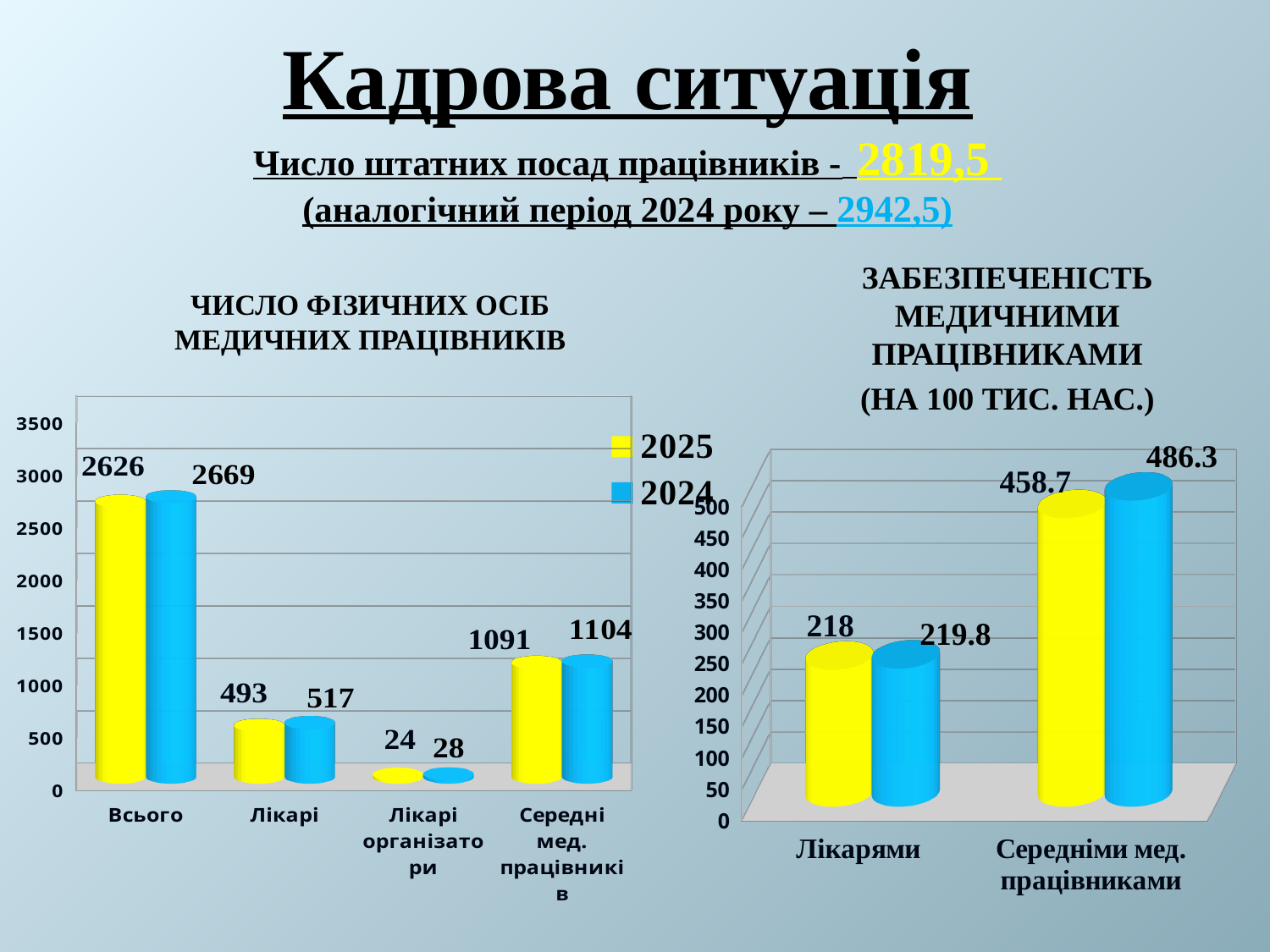
In the right chart (ЗАБЕЗПЕЧЕНІСТЬ МЕДИЧНИМИ ПРАЦІВНИКАМИ), what is the difference between the blue (2024) and yellow (2025) bars for Середніми мед. працівниками? 27.6 In the right chart (ЗАБЕЗПЕЧЕНІСТЬ МЕДИЧНИМИ ПРАЦІВНИКАМИ), what is the value of the yellow (2025) bar for Лікарями? 218 In the left chart (ЧИСЛО ФІЗИЧНИХ ОСІБ МЕДИЧНИХ ПРАЦІВНИКІВ), what is the 2025 value for Всього? 2626 In the left chart (ЧИСЛО ФІЗИЧНИХ ОСІБ МЕДИЧНИХ ПРАЦІВНИКІВ), how many categories are shown on the x axis? 4 In the right chart (ЗАБЕЗПЕЧЕНІСТЬ МЕДИЧНИМИ ПРАЦІВНИКАМИ), what is the value of the blue (2024) bar for Середніми мед. працівниками? 486.3 In the left chart (ЧИСЛО ФІЗИЧНИХ ОСІБ МЕДИЧНИХ ПРАЦІВНИКІВ), which series is shown in yellow? 2025 In the left chart (ЧИСЛО ФІЗИЧНИХ ОСІБ МЕДИЧНИХ ПРАЦІВНИКІВ), what is the 2024 value for Лікарі? 517 In the left chart (ЧИСЛО ФІЗИЧНИХ ОСІБ МЕДИЧНИХ ПРАЦІВНИКІВ), which category has the lowest values? Лікарі організатори In the left chart (ЧИСЛО ФІЗИЧНИХ ОСІБ МЕДИЧНИХ ПРАЦІВНИКІВ), what is the difference between the 2024 and 2025 values for Середні мед. працівники? 13 What kind of chart is the right chart (ЗАБЕЗПЕЧЕНІСТЬ МЕДИЧНИМИ ПРАЦІВНИКАМИ)? Bar chart In the left chart (ЧИСЛО ФІЗИЧНИХ ОСІБ МЕДИЧНИХ ПРАЦІВНИКІВ), how many series does the legend list? 2 In the right chart (ЗАБЕЗПЕЧЕНІСТЬ МЕДИЧНИМИ ПРАЦІВНИКАМИ), which is larger: the yellow bar for Лікарями or the yellow bar for Середніми мед. працівниками? Середніми мед. працівниками